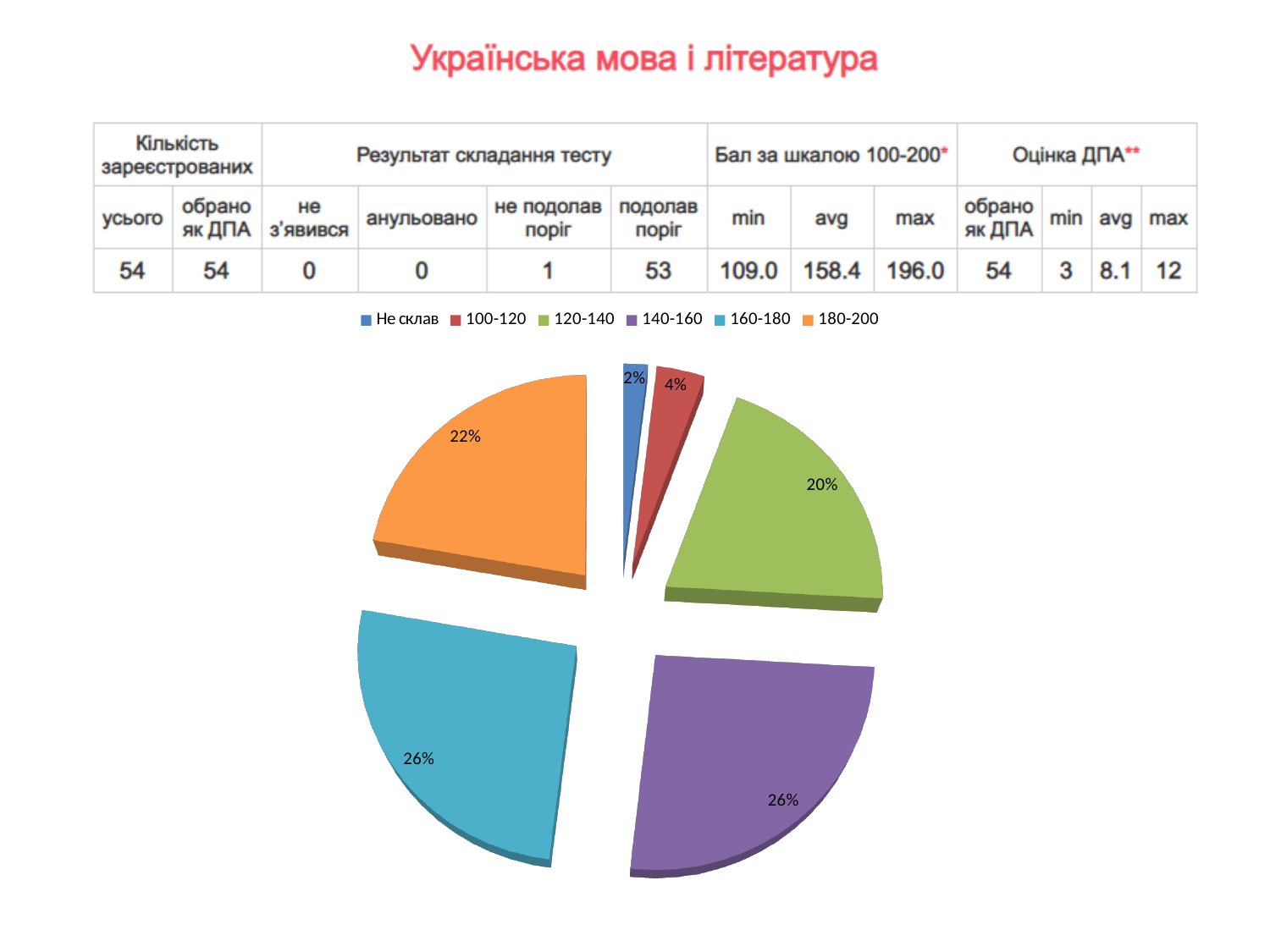
What kind of chart is shown on the slide? pie chart How many entries does the legend list? 6 What is the difference in percentage points between the "140-160" slice and the "100-120" slice? 22 What share of the pie does the "120-140" slice represent? 20% What share of the pie does the "160-180" slice represent? 26% Which slice is larger, "120-140" or "180-200"? 180-200 What share of the pie does the "Не склав" slice represent? 2% What colour is the "180-200" slice in the pie chart? orange Which category has the smallest slice of the pie? Не склав How many slices does the pie chart have? 6